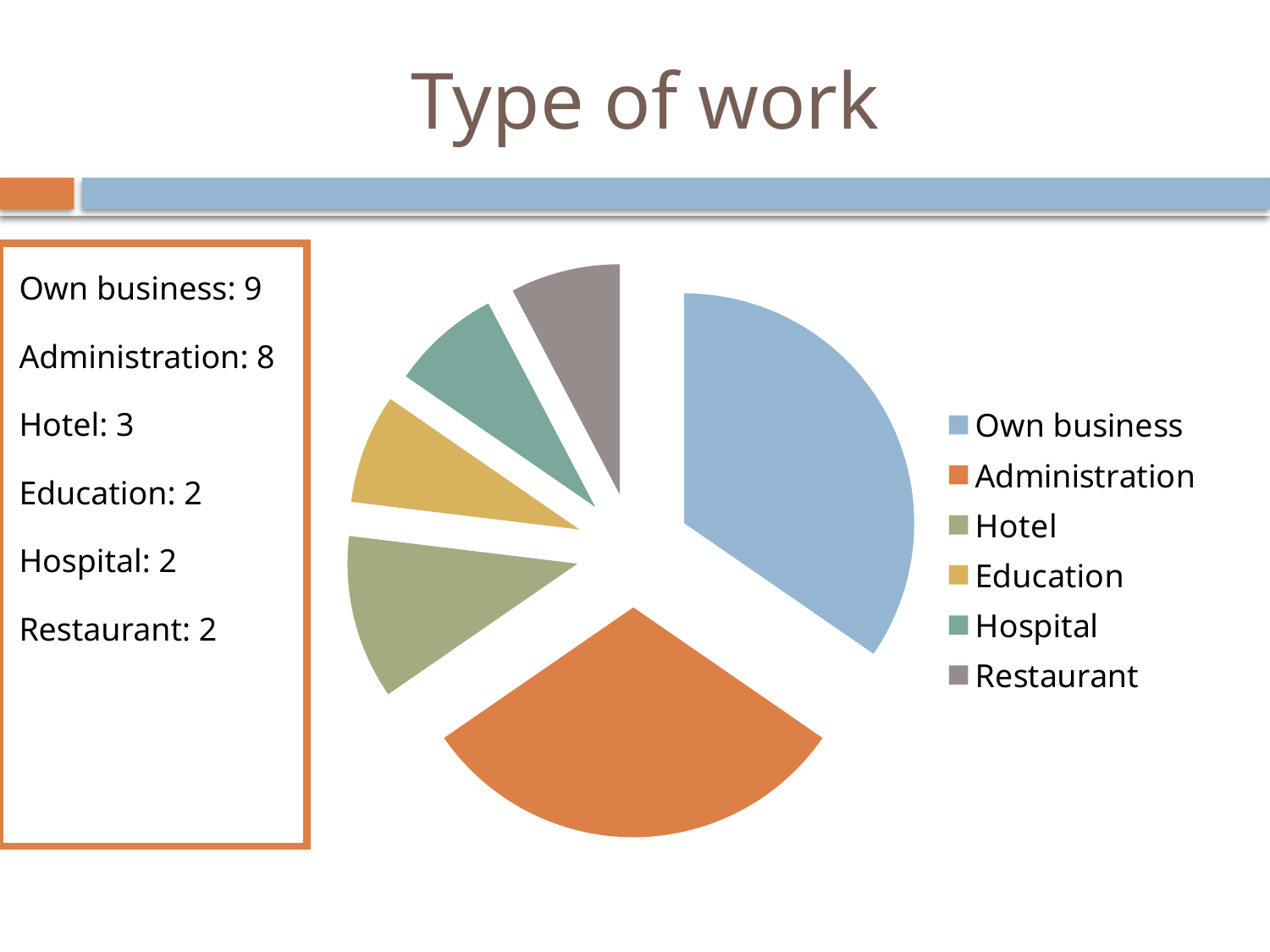
What is the value for Own business? 9 What is the value for Hotel? 3 What type of chart is shown on the slide? pie chart Which category has the largest slice of the pie? Own business What is the value for Education? 2 What is the title of the slide containing the chart? Type of work What is the difference between the values for Hotel and Hospital? 1 What is the total of all the values shown for the pie chart? 26 How many categories does the pie chart have? 6 What is the value for Administration? 8 What is the difference between the values for Own business and Administration? 1 Which is larger, Own business or Administration? Own business